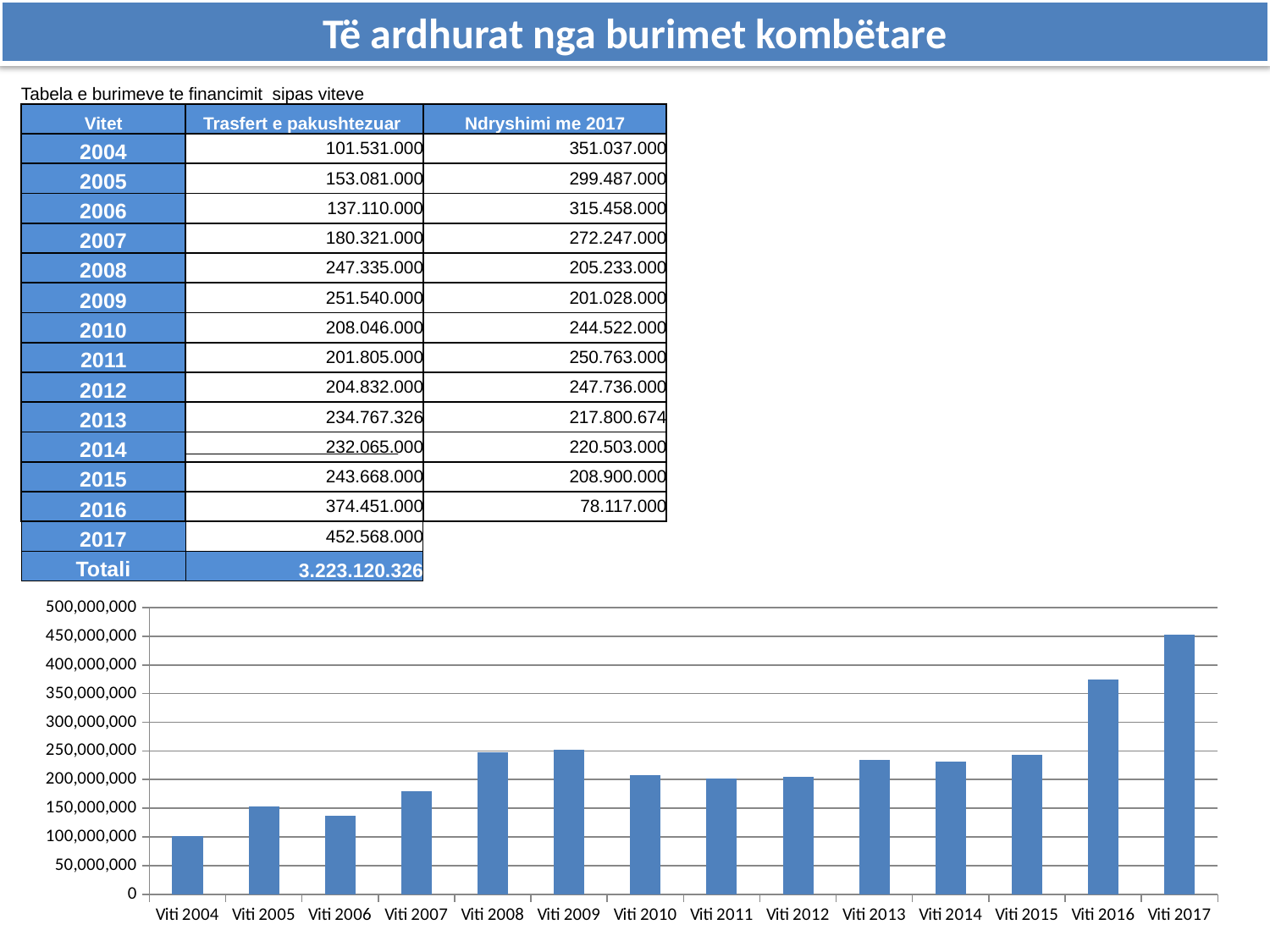
Which year has the shortest bar in the chart? Viti 2004 Is the value for Viti 2017 greater or less than 400,000,000? greater Overall, do the values rise or fall from Viti 2004 to Viti 2017? rise What is the highest value shown on the chart's vertical axis? 500,000,000 Is the value for Viti 2016 greater or less than 400,000,000? less Which is larger in the chart, the bar for Viti 2015 or the bar for Viti 2016? Viti 2016 What kind of chart is shown at the bottom of the slide? bar chart Which year has the tallest bar in the chart? Viti 2017 Is the value for Viti 2007 greater or less than 150,000,000? greater Which is larger in the chart, the bar for Viti 2012 or the bar for Viti 2013? Viti 2013 How many bars (years) does the chart show? 14